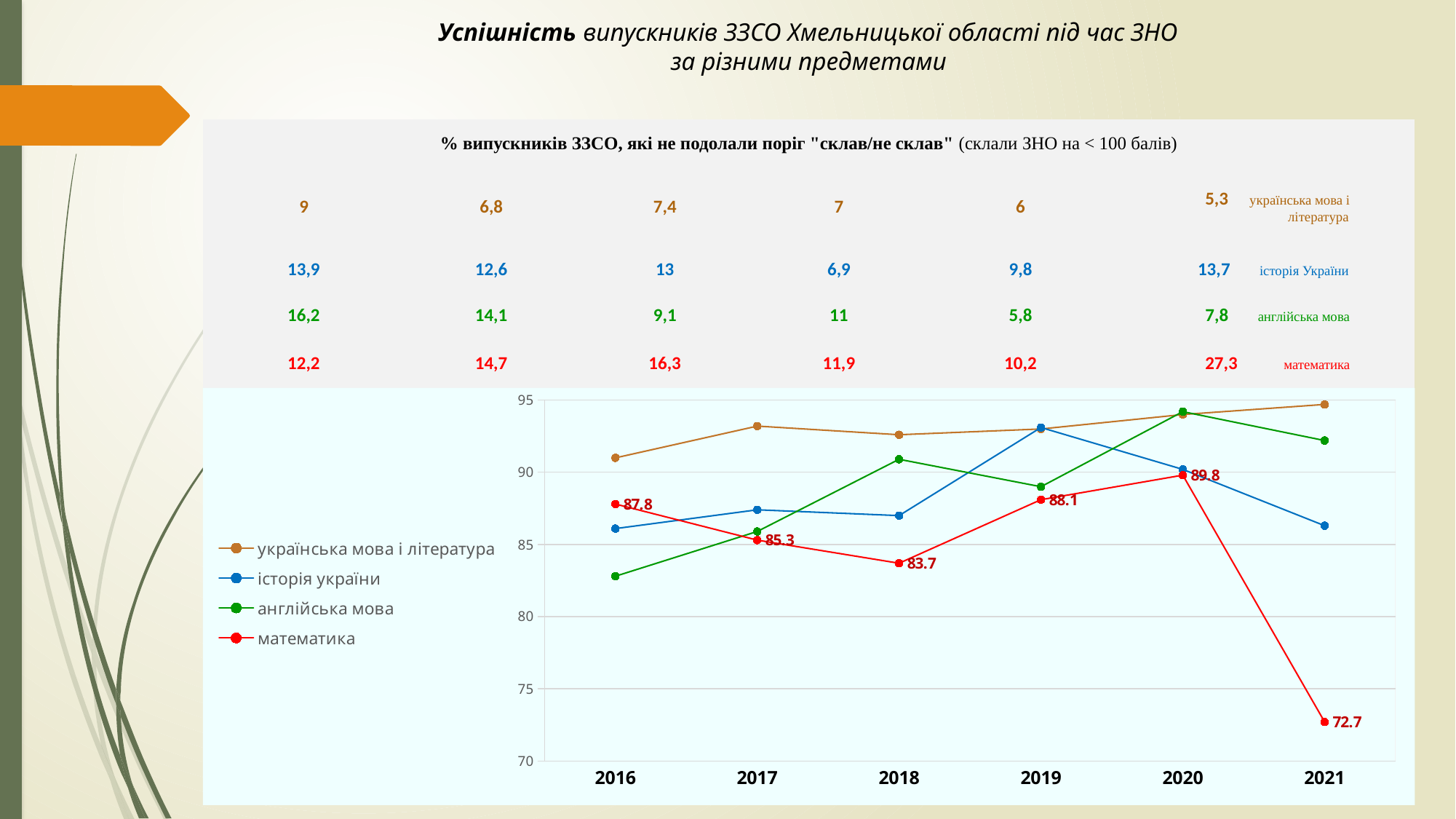
What is the value for математика in 2021? 72.7 Is the value for українська мова і література in 2016 greater or less than 90? greater Is the value for англійська мова in 2016 greater or less than 85? less What is the difference between the математика values for 2020 and 2021? 17.1 What is the value for математика in 2016? 87.8 In which year is the value for математика lowest? 2021 How many years are plotted along the x axis of the chart? 6 What kind of chart is shown on the slide? line chart In 2021, which is higher: українська мова і література or математика? українська мова і література In which year is the value for математика highest? 2020 Does the математика line rise or fall from 2020 to 2021? fall How many series does the chart legend list? 4